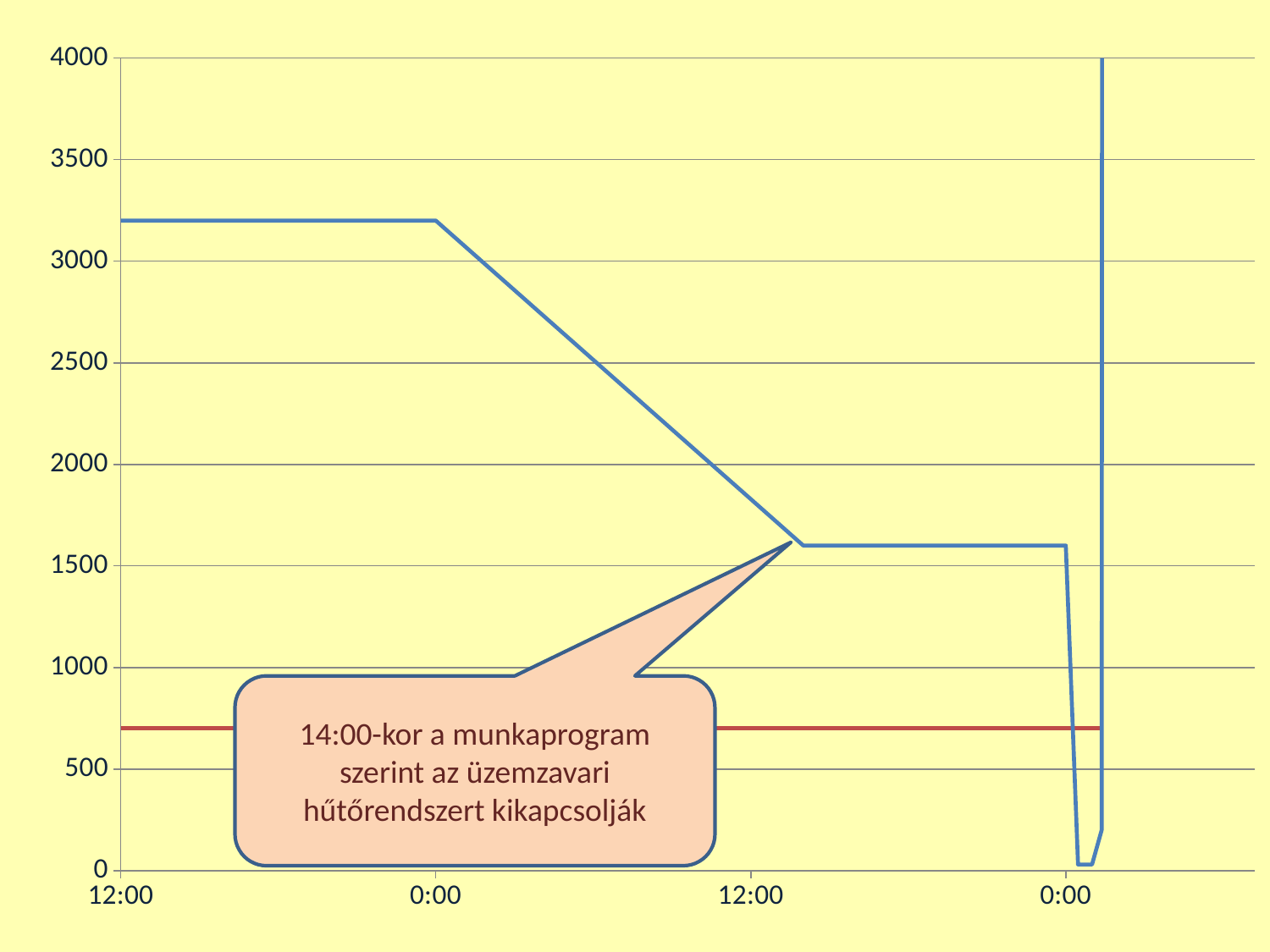
What text is written in the callout box on the chart? 14:00-kor a munkaprogram szerint az üzemzavari hűtőrendszert kikapcsolják Is the value of the red horizontal line greater or less than 1000? less Is the value of the blue line at the first 12:00 tick greater or less than 3000? greater Is the value of the blue line at the first 0:00 tick greater or less than 3000? greater What kind of chart is shown on the slide? line chart Which is higher at the first 12:00 tick: the blue line or the red line? the blue line Does the blue line rise, fall or stay flat between the first 12:00 tick and the first 0:00 tick? stay flat How many tick labels are shown on the x axis? 4 Does the blue line rise, fall or stay flat between the first 0:00 tick and the second 12:00 tick? fall Which is larger: the blue line's value at the first 0:00 tick or at the second 12:00 tick? first 0:00